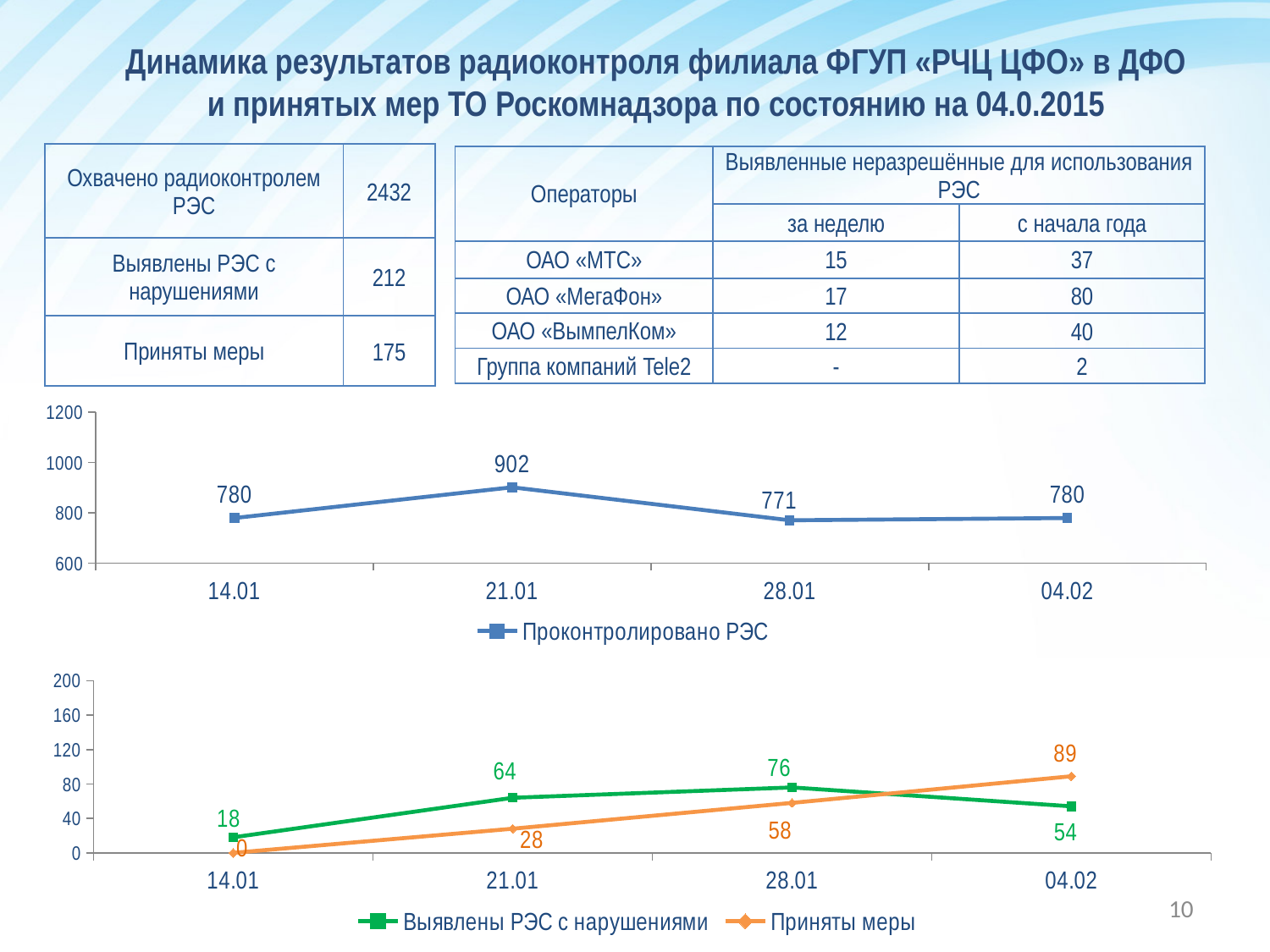
In the top chart, what is the difference between the values on 21.01 and 28.01? 131 In the bottom chart, what is the value of Приняты меры on 04.02? 89 In the bottom chart, does the Приняты меры series rise or fall from 14.01 to 04.02? rise In the bottom chart, which is larger on 04.02: Выявлены РЭС с нарушениями or Приняты меры? Приняты меры In the top chart, on which date is Проконтролировано РЭС lowest? 28.01 How many series does the legend of the bottom chart list? 2 What type of chart is the top chart? line chart In the top chart, what is the value of Проконтролировано РЭС on 21.01? 902 In the top chart, on which date is Проконтролировано РЭС highest? 21.01 In the bottom chart, what is the difference between Выявлены РЭС с нарушениями and Приняты меры on 21.01? 36 In the bottom chart, what is the value of Выявлены РЭС с нарушениями on 28.01? 76 How many data points are plotted in the top chart? 4